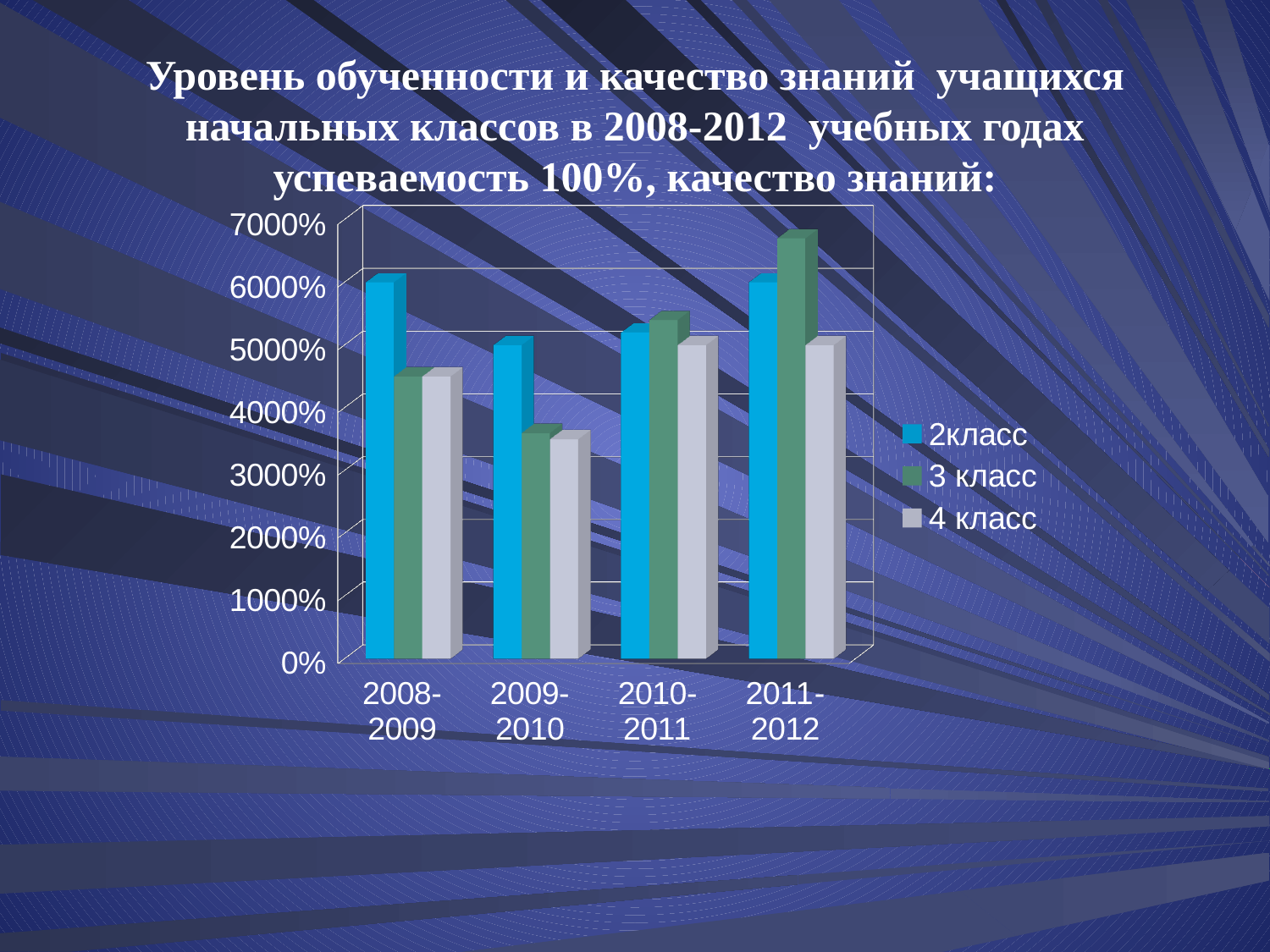
In which school year is the value for 3 класс the highest? 2011-2012 Is the value for 4 класс in 2011-2012 greater or less than 6000%? less Is the value for 2класс in 2008-2009 greater or less than 5000%? greater Is the value for 3 класс in 2009-2010 greater or less than 4000%? less What are the three series named in the legend? 2класс, 3 класс, 4 класс How many series does the legend list? 3 In 2011-2012, which is larger: the value for 2класс or for 3 класс? 3 класс Which series has the highest value in 2009-2010? 2класс How many school-year categories are shown on the x axis? 4 What kind of chart is shown on the slide? bar chart In which school year is the value for 3 класс the lowest? 2009-2010